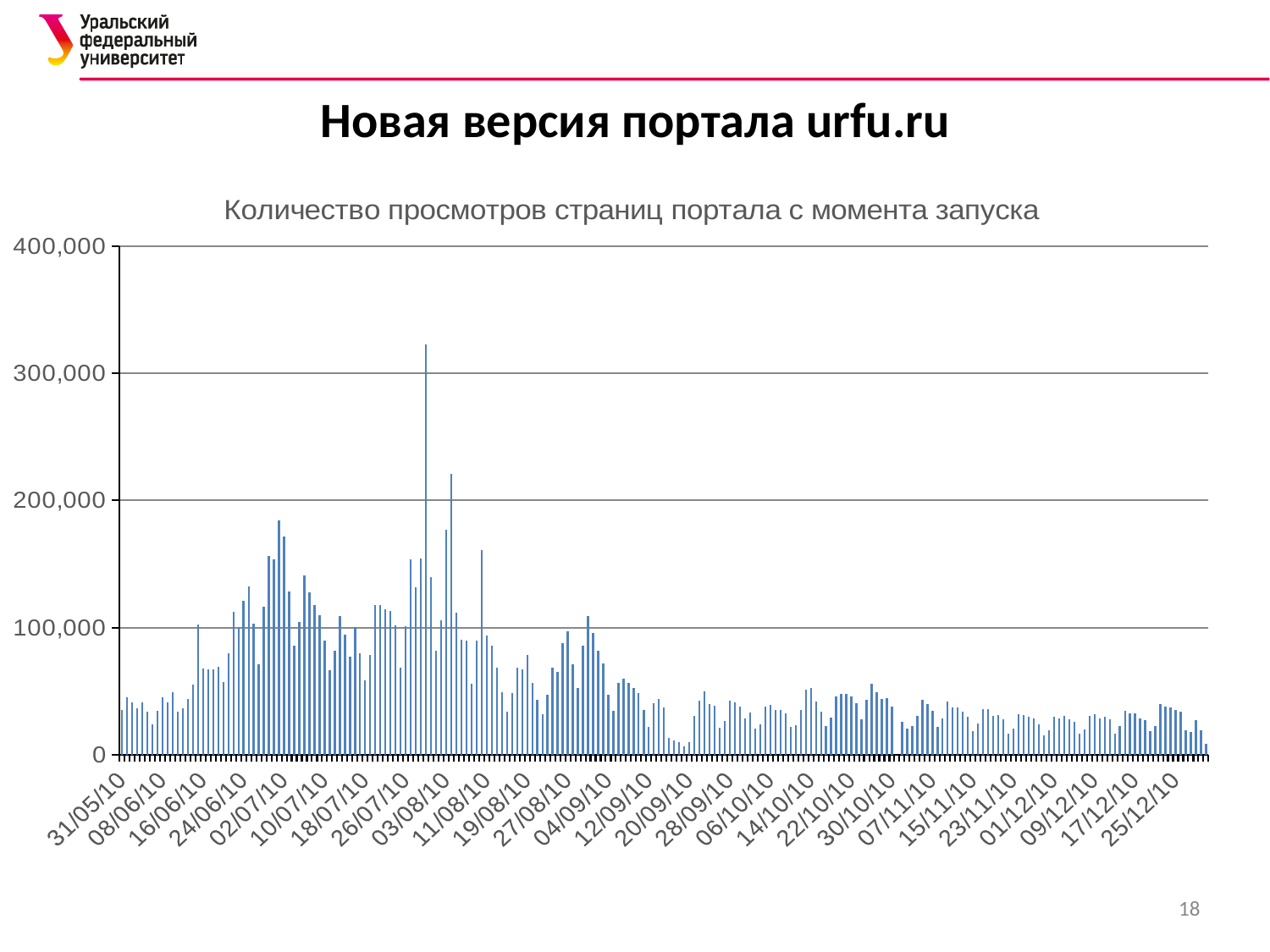
Is the value for 25/12/10 greater or less than 100,000? less What is the title of the chart? Количество просмотров страниц портала с момента запуска Do the values generally rise or fall from 04/09/10 to 25/12/10? fall What kind of chart is shown on the slide? bar chart Which is larger, the value for 02/07/10 or the value for 25/12/10? 02/07/10 Is the value of the tallest bar in the chart greater or less than 300,000? greater Do the values generally rise or fall from 31/05/10 to 02/07/10? rise What is the highest value shown on the y axis of the chart? 400,000 Is the value for 02/07/10 greater or less than 100,000? greater